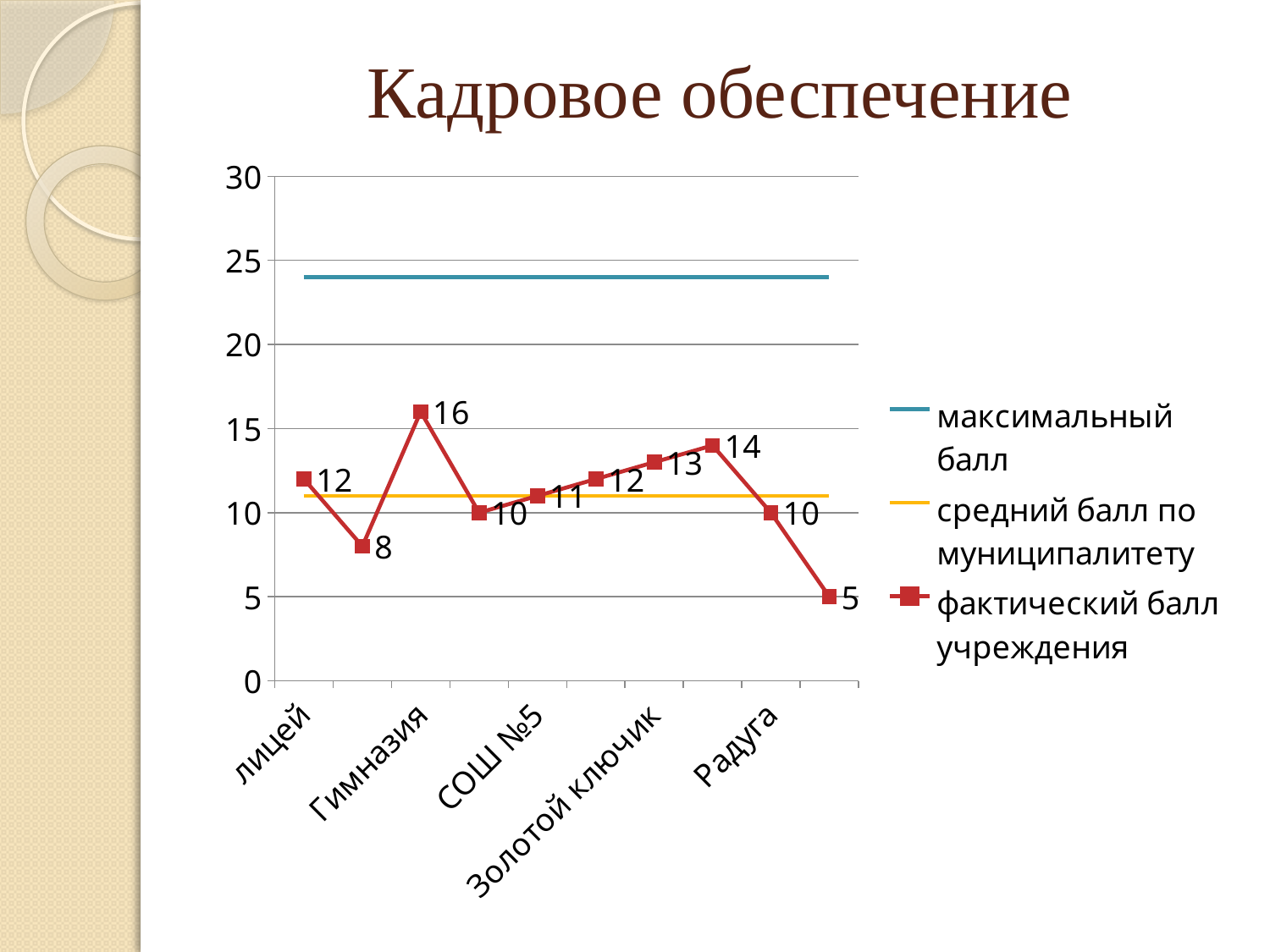
What is the difference between the фактический балл учреждения values for Гимназия and лицей? 4 What is the фактический балл учреждения value for СОШ №5? 11 What is the фактический балл учреждения value for Золотой ключик? 13 What is the фактический балл учреждения value for Гимназия? 16 What kind of chart is shown on the slide? line chart What is the lowest value labelled on the фактический балл учреждения line? 5 Is the value of the максимальный балл line greater or less than 20? greater How many series does the legend list? 3 Which labelled category has the highest фактический балл учреждения? Гимназия Which has the larger фактический балл учреждения, Золотой ключик or Радуга? Золотой ключик What is the фактический балл учреждения value for лицей? 12 What is the фактический балл учреждения value for Радуга? 10